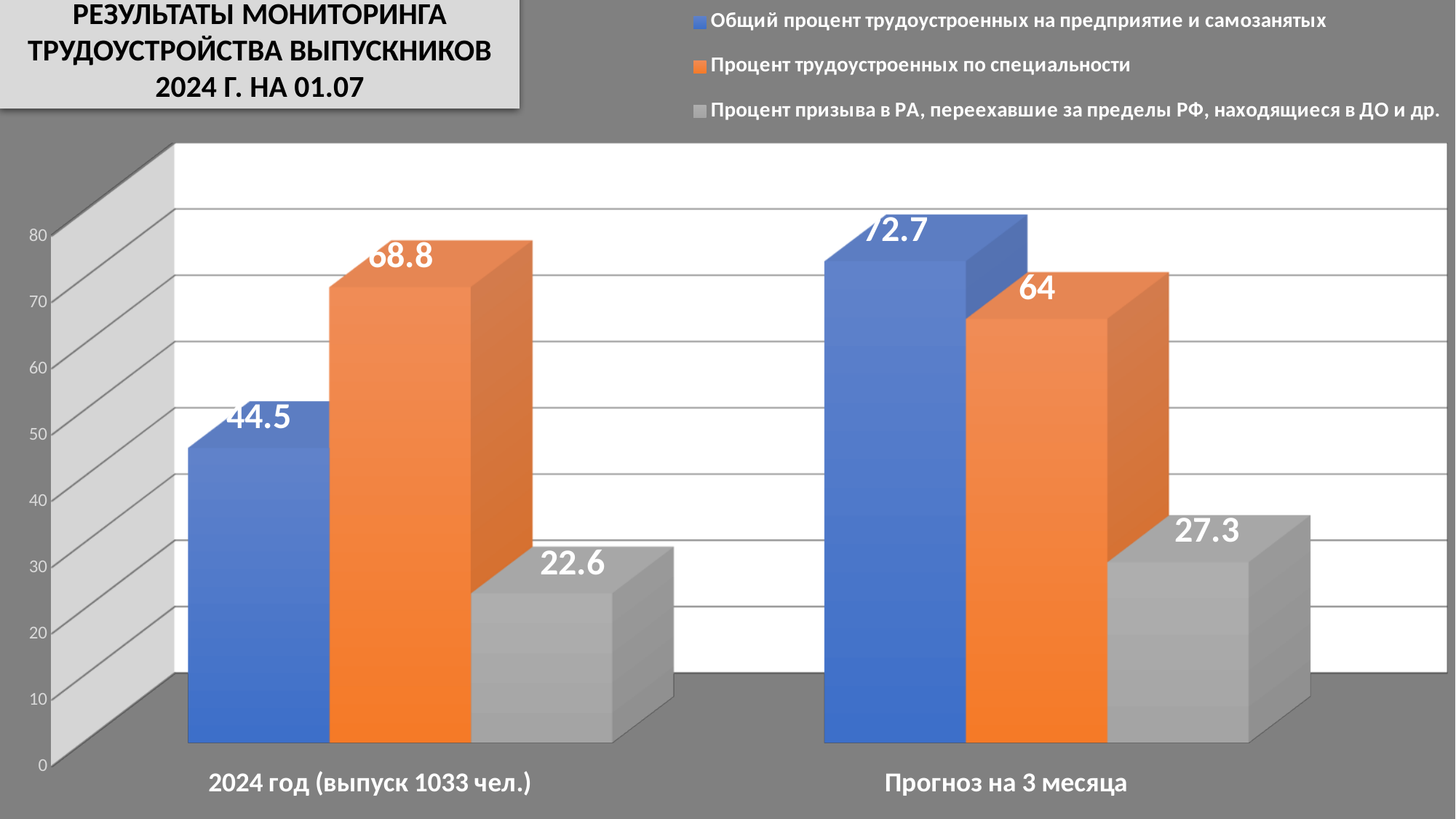
How many series does the legend list? 3 Which series has the lowest value for '2024 год (выпуск 1033 чел.)'? Процент призыва в РА, переехавшие за пределы РФ, находящиеся в ДО и др. What is the value of 'Процент трудоустроенных по специальности' for 'Прогноз на 3 месяца'? 64 What is the value of 'Общий процент трудоустроенных на предприятие и самозанятых' for '2024 год (выпуск 1033 чел.)'? 44.5 Is the value of 'Процент призыва в РА, переехавшие за пределы РФ, находящиеся в ДО и др.' for 'Прогноз на 3 месяца' greater or less than 30? less How many categories are shown on the x axis? 2 What is the value of 'Процент призыва в РА, переехавшие за пределы РФ, находящиеся в ДО и др.' for '2024 год (выпуск 1033 чел.)'? 22.6 What is the difference between the 'Общий процент трудоустроенных на предприятие и самозанятых' values for 'Прогноз на 3 месяца' and '2024 год (выпуск 1033 чел.)'? 28.2 Which is larger: 'Процент трудоустроенных по специальности' for '2024 год (выпуск 1033 чел.)' or for 'Прогноз на 3 месяца'? 2024 год (выпуск 1033 чел.) What colour represents 'Процент трудоустроенных по специальности' in the legend? orange Which series has the highest value for 'Прогноз на 3 месяца'? Общий процент трудоустроенных на предприятие и самозанятых What kind of chart is shown on the slide? bar chart